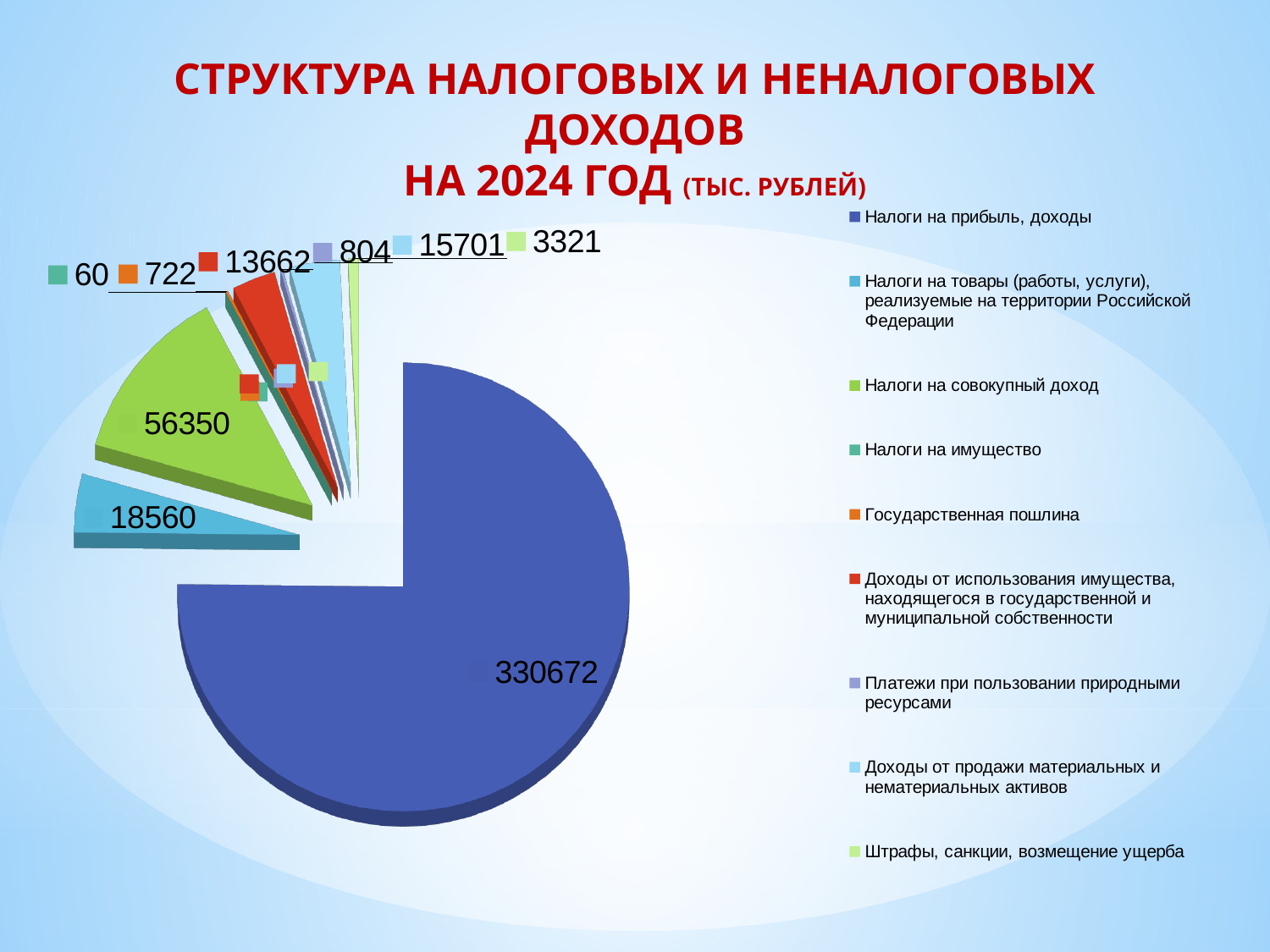
Which category has the smallest value? Налоги на имущество What is the value for "Налоги на товары (работы, услуги), реализуемые на территории Российской Федерации"? 18560 What is the unit of measurement stated in the chart title? тыс. рублей What is the value for "Платежи при пользовании природными ресурсами"? 804 What type of chart is shown on the slide? Pie chart How many categories does the legend list? 9 What is the value for "Налоги на совокупный доход"? 56350 What is the difference between "Налоги на совокупный доход" and "Налоги на товары (работы, услуги), реализуемые на территории Российской Федерации"? 37790 What is the value for "Налоги на прибыль, доходы"? 330672 What is the value for "Штрафы, санкции, возмещение ущерба"? 3321 Which category has the largest value? Налоги на прибыль, доходы Which is larger: "Доходы от продажи материальных и нематериальных активов" or "Доходы от использования имущества, находящегося в государственной и муниципальной собственности"? Доходы от продажи материальных и нематериальных активов